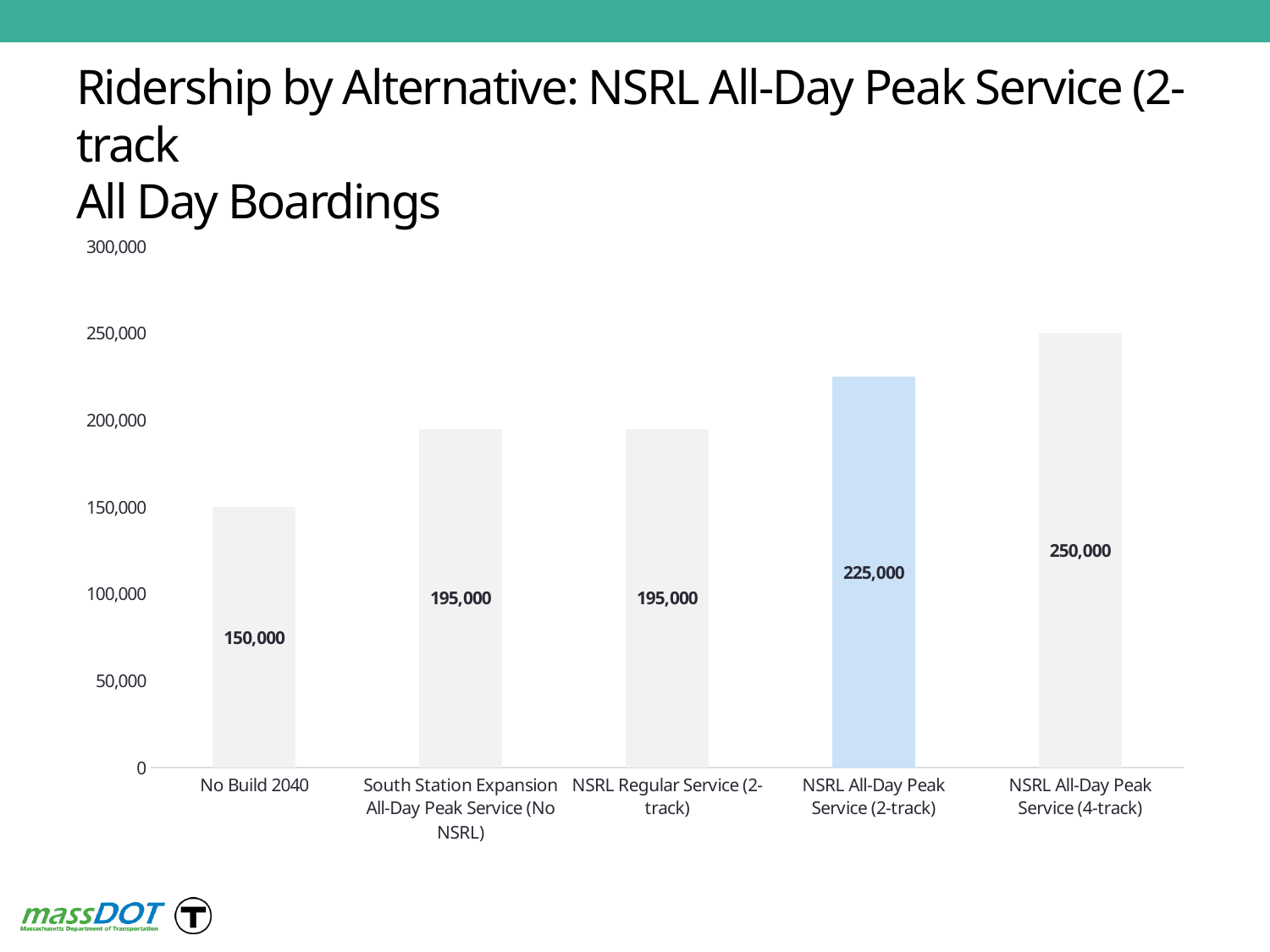
How many categories are shown on the x axis? 5 Which is larger, NSRL All-Day Peak Service (2-track) or South Station Expansion All-Day Peak Service (No NSRL)? NSRL All-Day Peak Service (2-track) What is the difference between NSRL All-Day Peak Service (4-track) and No Build 2040? 100,000 What is the value for NSRL All-Day Peak Service (4-track)? 250,000 What is the value for NSRL All-Day Peak Service (2-track)? 225,000 Which category has the lowest value? No Build 2040 Which category has the highest value? NSRL All-Day Peak Service (4-track) Which bar is highlighted in a different colour (blue) from the others? NSRL All-Day Peak Service (2-track) What is the value for NSRL Regular Service (2-track)? 195,000 What is the difference between NSRL All-Day Peak Service (2-track) and NSRL Regular Service (2-track)? 30,000 What kind of chart is this? Bar chart What is the value for No Build 2040? 150,000